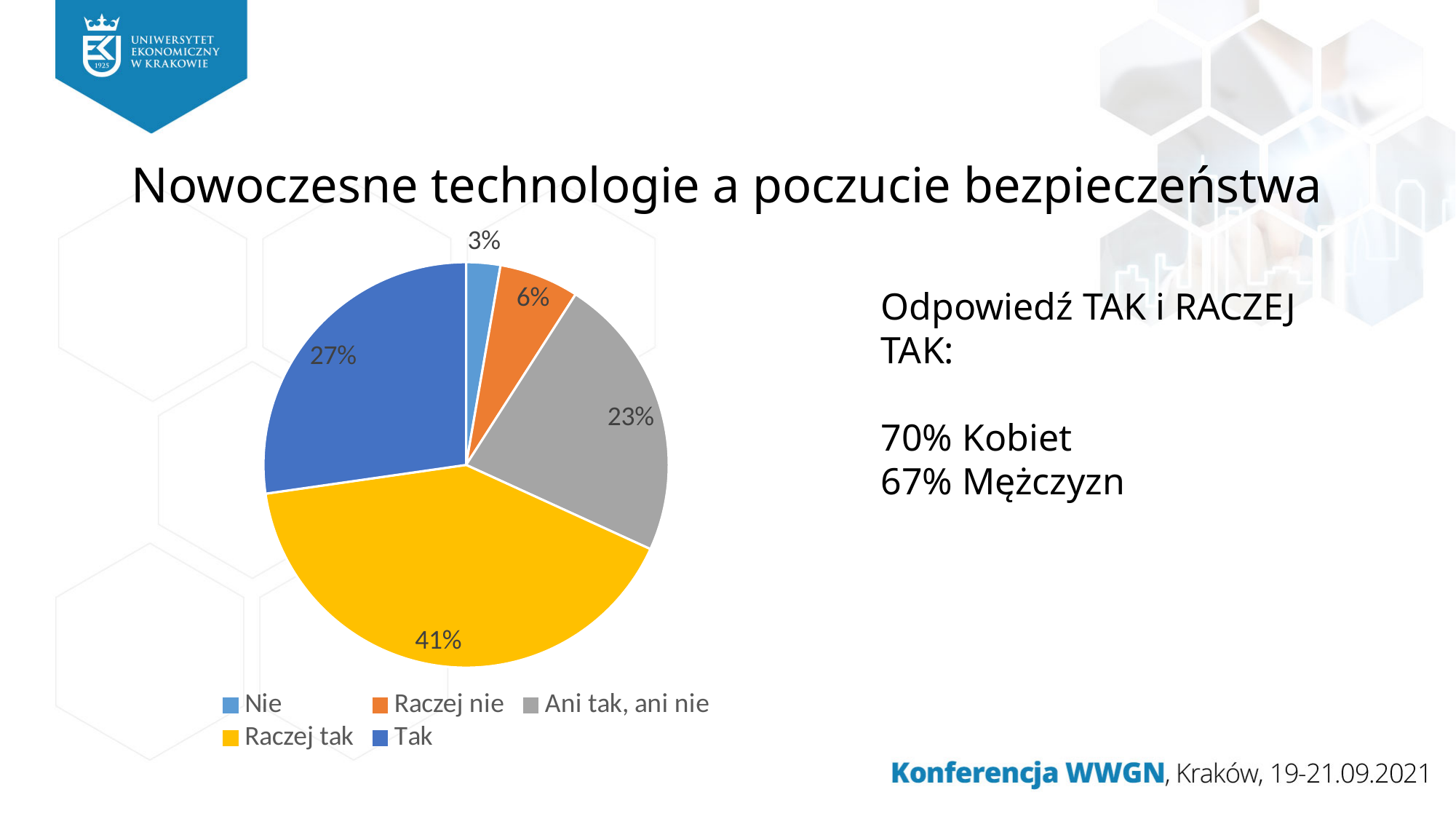
How many categories does the pie chart have? 5 What percentage of the pie is the 'Ani tak, ani nie' slice? 23% Which slice is larger, 'Ani tak, ani nie' or 'Raczej nie'? Ani tak, ani nie Which category has the smallest slice of the pie? Nie What percentage of the pie is the 'Raczej nie' slice? 6% Which category has the largest slice of the pie? Raczej tak What colour is the 'Raczej tak' slice? yellow What is the difference in percentage points between the 'Raczej tak' and 'Tak' slices? 14 What kind of chart is shown on the slide? pie chart What percentage of the pie is the 'Tak' slice? 27% What percentage of the pie is the 'Nie' slice? 3% What percentage of the pie is the 'Raczej tak' slice? 41%